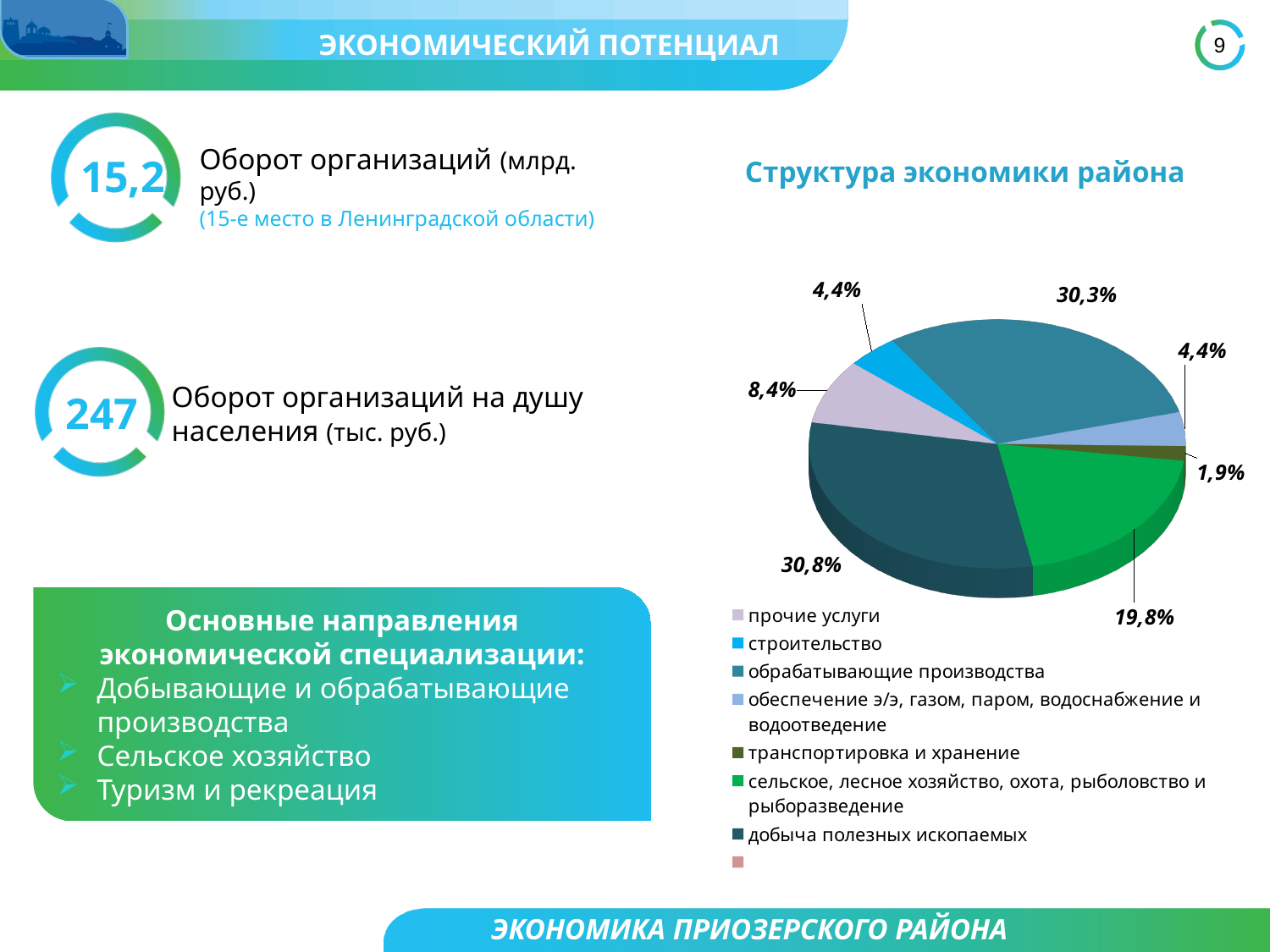
What share of the pie does "прочие услуги" have? 8,4% What type of chart is shown under the title "Структура экономики района"? pie chart Which category has the largest slice of the pie? добыча полезных ископаемых What share of the pie does "сельское, лесное хозяйство, охота, рыболовство и рыборазведение" have? 19,8% What share of the pie does "транспортировка и хранение" have? 1,9% What is the title of the pie chart on the slide? Структура экономики района What share of the pie does "добыча полезных ископаемых" have? 30,8% Which category has the smallest slice of the pie? транспортировка и хранение How many slices of the pie have a percentage label printed? 7 What share of the pie does "обрабатывающие производства" have? 30,3% Which is larger: the share of "прочие услуги" or the share of "строительство"? прочие услуги What is the difference between the shares of "добыча полезных ископаемых" and "сельское, лесное хозяйство, охота, рыболовство и рыборазведение"? 11,0%